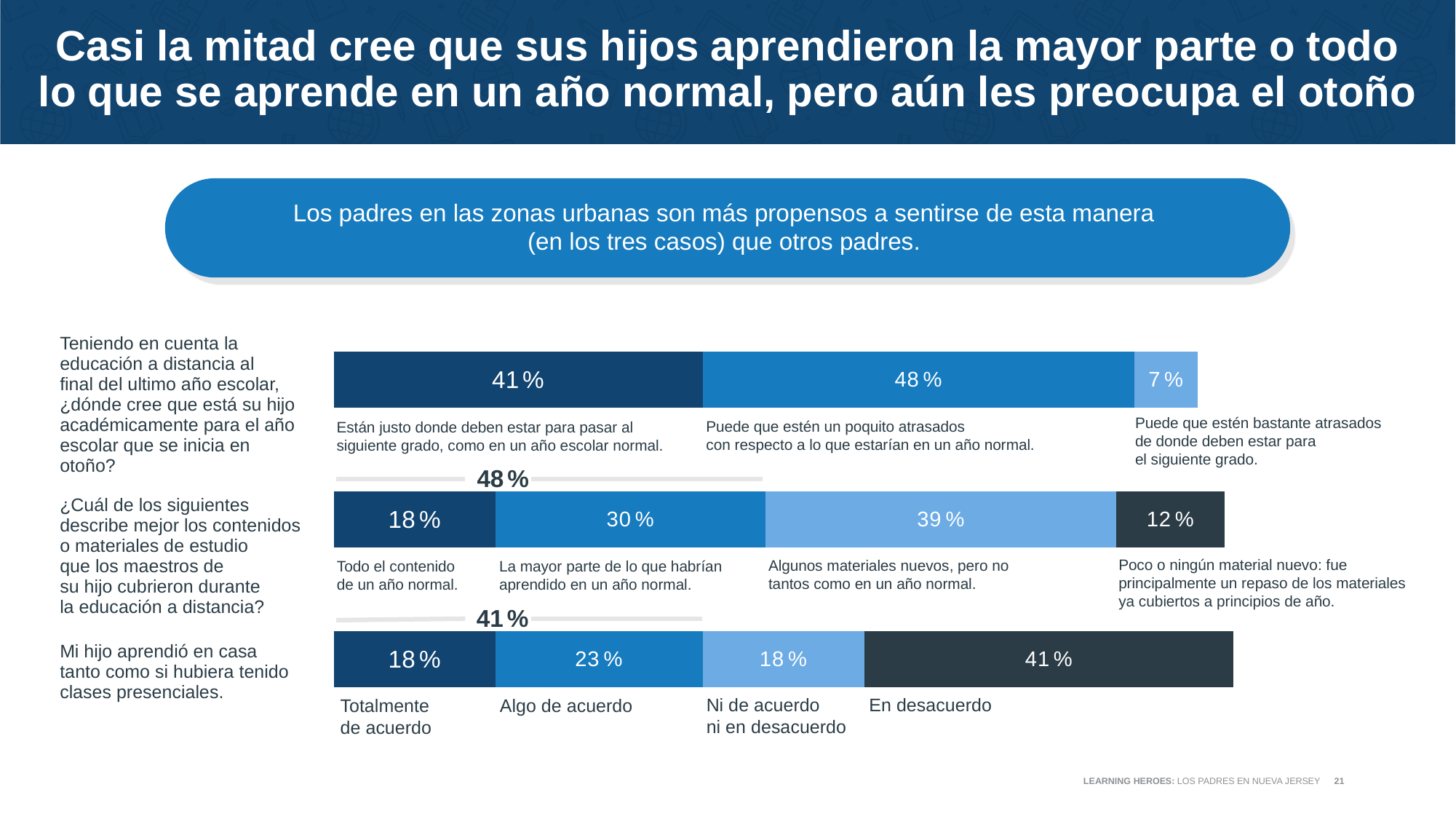
In the top bar chart, which segment is the smallest? Puede que estén bastante atrasados (7%) In the top bar chart, what percentage say their child may be a little behind ("Puede que estén un poquito atrasados")? 48% In the middle bar chart, what percentage chose "Algunos materiales nuevos, pero no tantos como en un año normal"? 39% In the top bar chart, how many segments make up the bar? 3 In the middle bar chart, what percentage chose "Poco o ningún material nuevo"? 12% What type of chart is used on this slide? Stacked bar chart In the top bar chart, what percentage of parents say their child is just where they should be to pass to the next grade ("Están justo donde deben estar")? 41% In the bottom bar chart, what percentage of parents are "En desacuerdo" with the statement that their child learned as much at home as in in-person classes? 41% In the middle bar chart, what is the combined percentage shown above the first two segments ("Todo el contenido" and "La mayor parte")? 48% In the bottom bar chart, what is the difference between "Algo de acuerdo" and "Totalmente de acuerdo"? 5% In the bottom bar chart, which is larger: "En desacuerdo" or "Algo de acuerdo"? En desacuerdo In the middle bar chart, which segment is the largest? Algunos materiales nuevos, pero no tantos como en un año normal (39%)